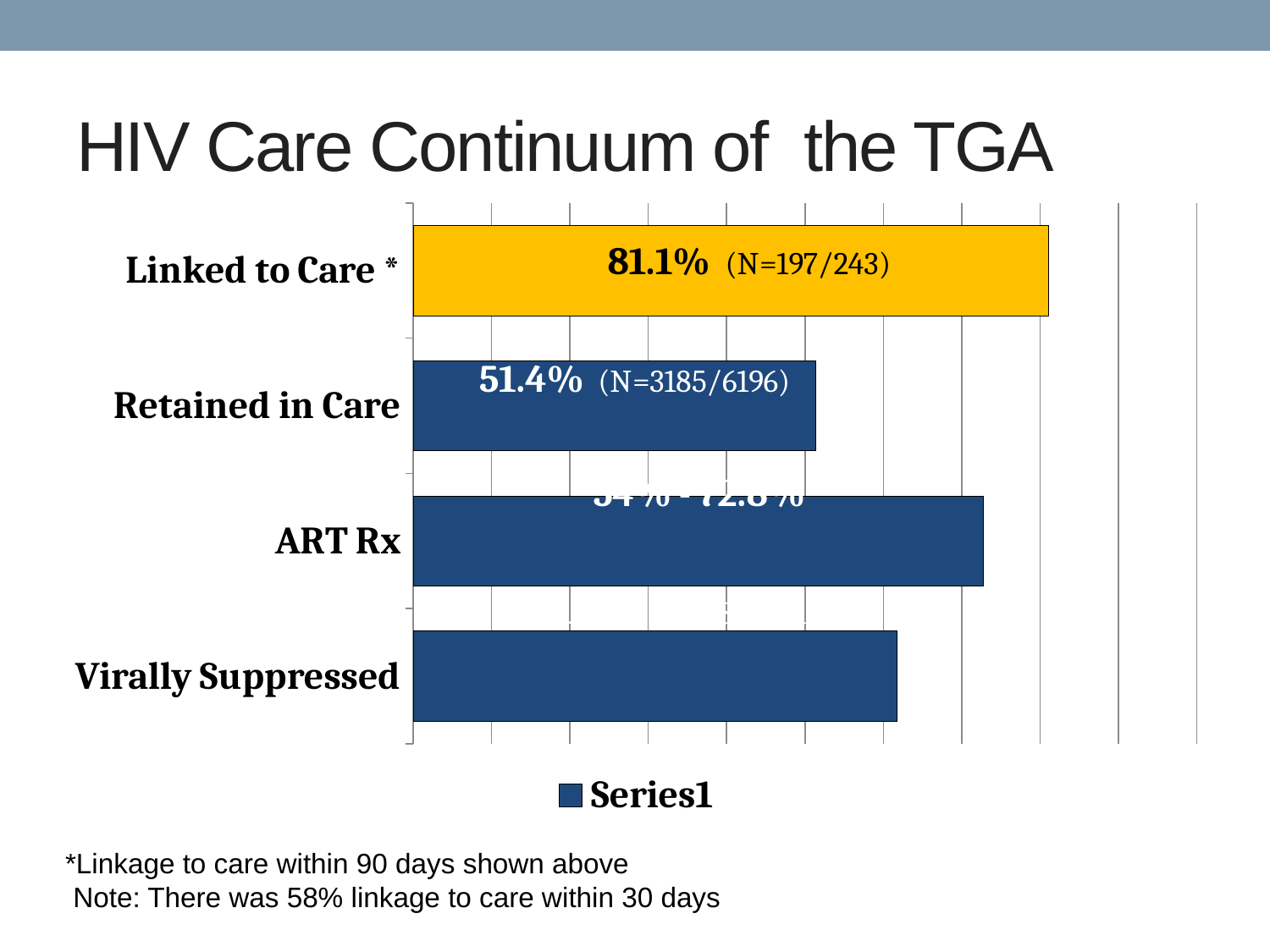
What is the difference in percentage points between Linked to Care * and Retained in Care? 29.7 What N fraction is printed next to the Retained in Care bar? N=3185/6196 What is the title of the slide? HIV Care Continuum of the TGA How many series does the legend list? 1 What kind of chart is shown on the slide? Bar chart Which category has the shortest bar? Retained in Care Which category has the longest bar? Linked to Care * How many categories are shown on the chart? 4 What is the value shown for Linked to Care *? 81.1% What is the value shown for Retained in Care? 51.4% Which bar is longer, ART Rx or Virally Suppressed? ART Rx What N fraction is printed next to the Linked to Care * bar? N=197/243